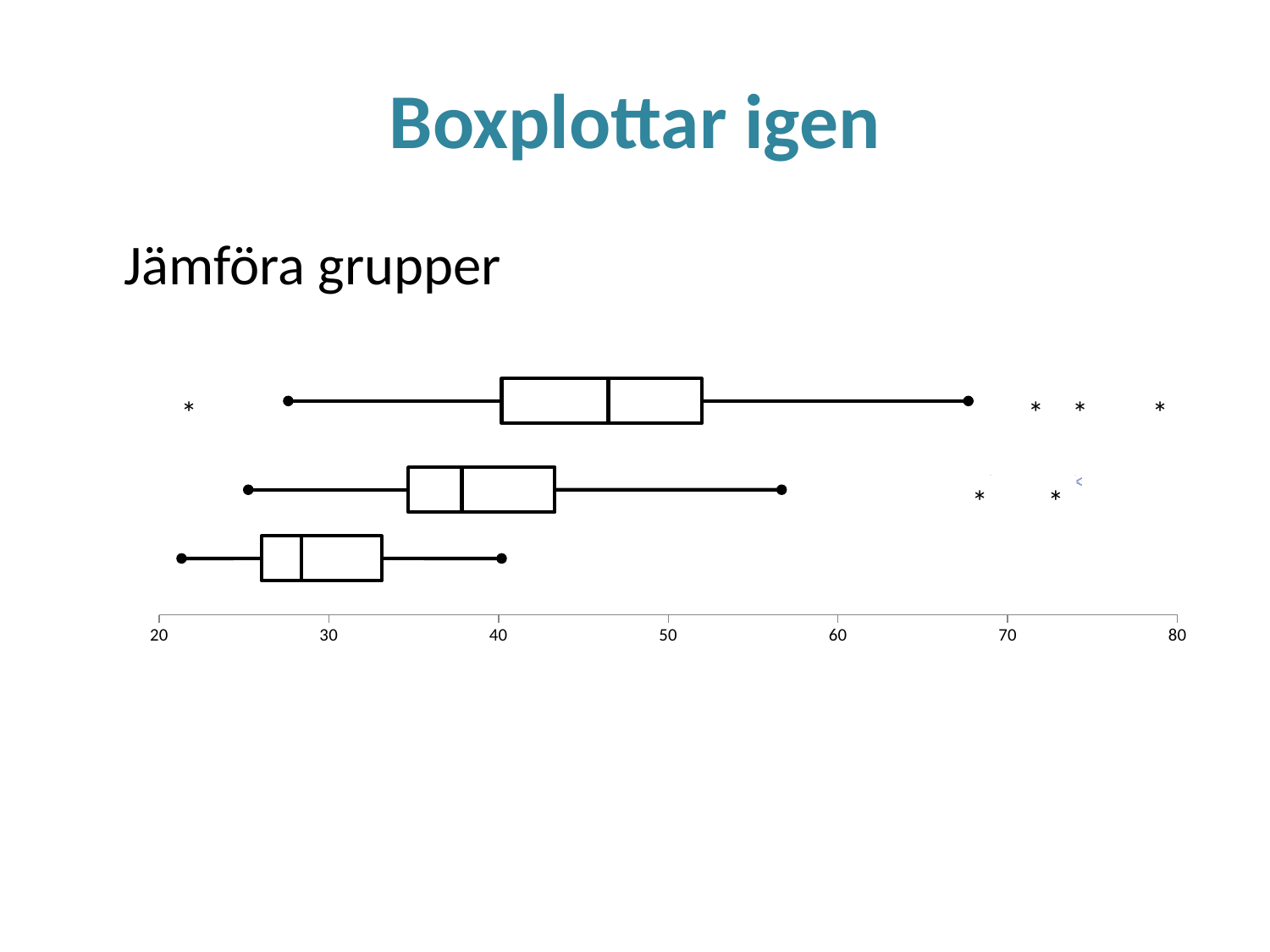
Is the right whisker end of the middle boxplot greater or less than 50? greater Is the right whisker end of the top boxplot greater or less than 60? greater How many boxplots are shown in the chart? 3 Which boxplot has the lowest median: the top, middle or bottom one? Bottom Is the median of the top boxplot greater or less than 40? greater Which boxplot has the wider box: the top one or the bottom one? Top How many outlier asterisks are shown for the top boxplot? 4 What kind of chart is shown on the slide? Box plot What is the title of the slide containing the chart? Boxplottar igen Which boxplot has the highest median: the top, middle or bottom one? Top